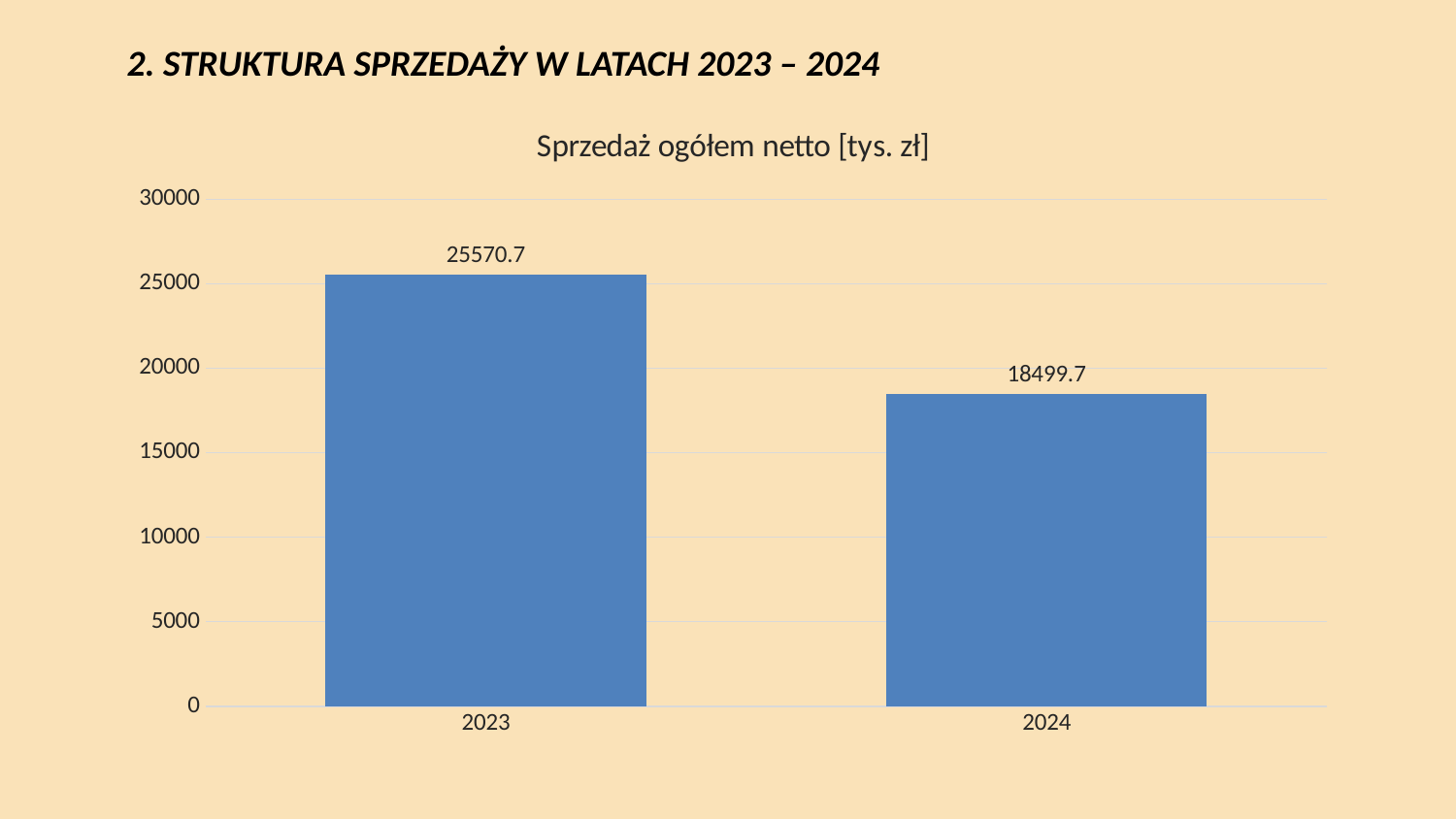
What kind of chart is shown on the slide? bar chart What is the difference between the values for 2023 and 2024? 7071.0 Do the values rise or fall from 2023 to 2024? fall What is the value for 2024? 18499.7 How many categories are shown on the x axis? 2 Which year has the lowest value? 2024 What is the value for 2023? 25570.7 What is the title of the chart? Sprzedaż ogółem netto [tys. zł] Which year has the highest value? 2023 Which is larger, the value for 2023 or the value for 2024? 2023 Is the value for 2023 greater or less than 25000? greater Is the value for 2024 greater or less than 20000? less